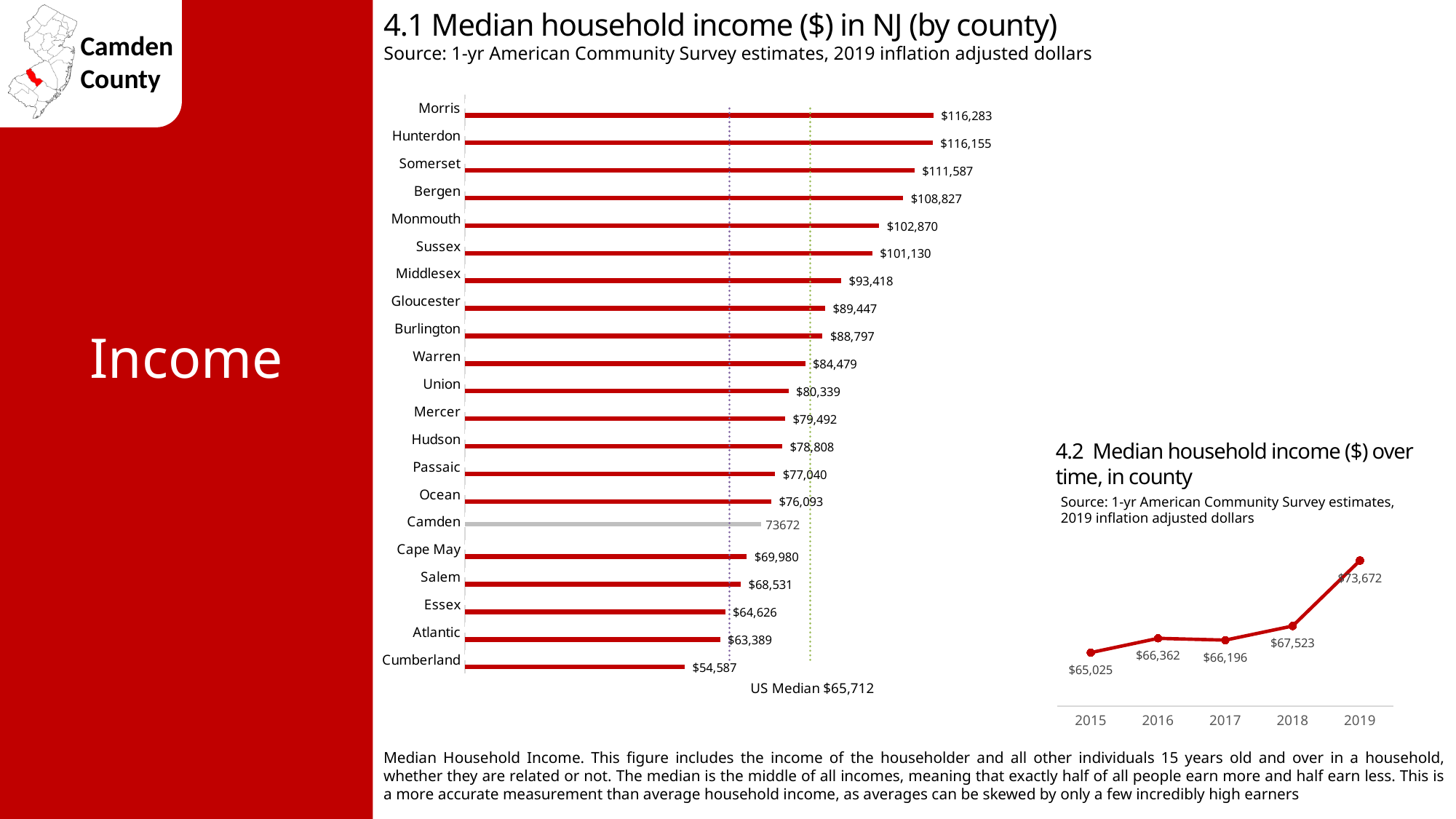
In chart 4.2, how many years are plotted on the x axis? 5 In chart 4.1, which county has a higher median household income, Bergen or Monmouth? Bergen In chart 4.1, what US Median value is noted below the chart? $65,712 In chart 4.1, what value is shown for Camden? 73672 In chart 4.1 (Median household income in NJ by county), what is the median household income for Gloucester? $89,447 What type of chart is chart 4.1? Bar chart In chart 4.2, what is the difference between the 2019 and 2015 values? $8,647 In chart 4.2 (Median household income over time, in county), what is the value for 2017? $66,196 In chart 4.1, which county has the lowest median household income? Cumberland In chart 4.1, which county has the highest median household income? Morris In chart 4.1, what is the difference between the median household income of Morris and Cumberland? $61,696 In chart 4.1, how many counties are plotted? 21